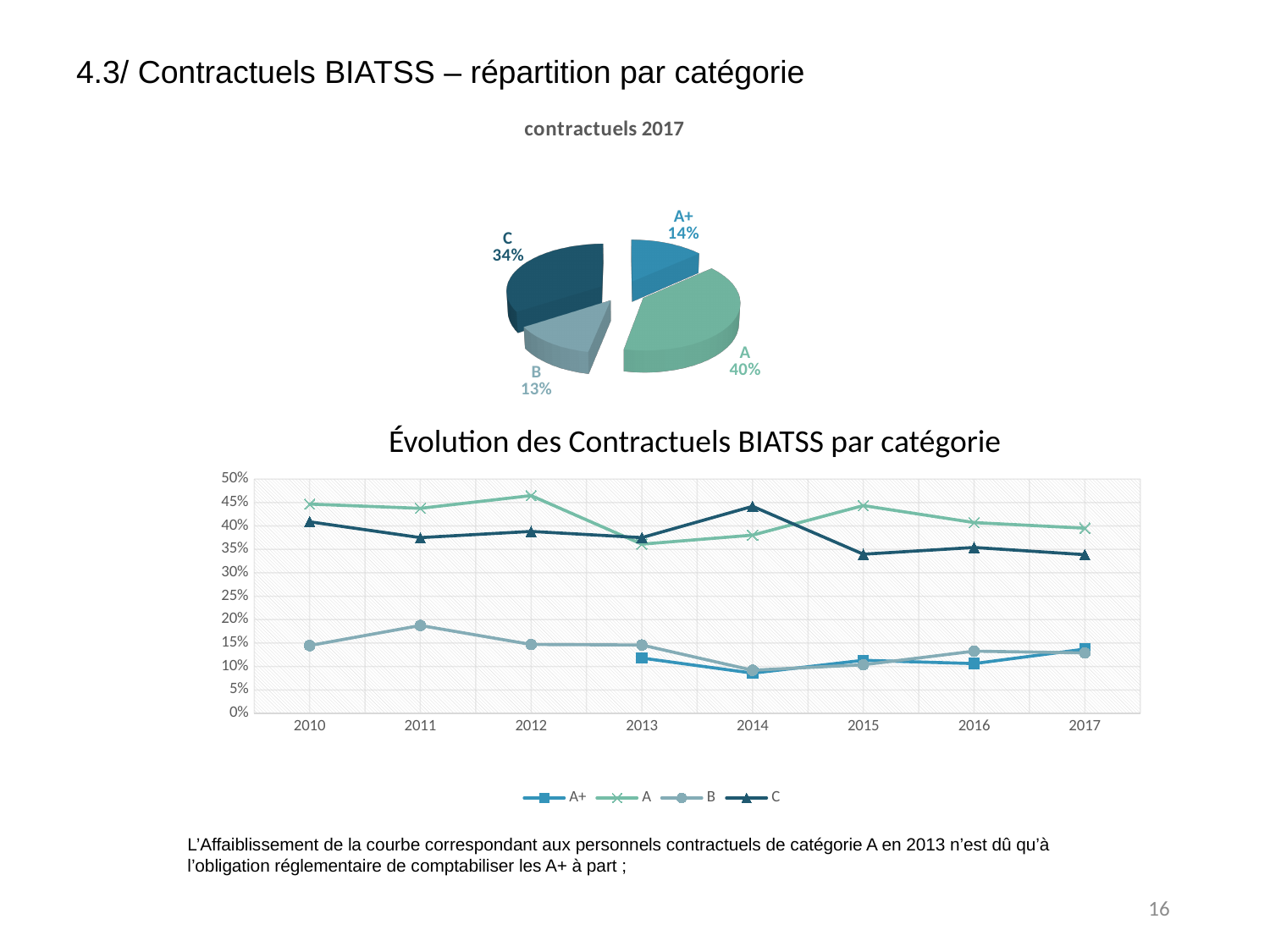
In the chart 'Évolution des Contractuels BIATSS par catégorie', how many years are shown on the x axis? 8 In the pie chart 'contractuels 2017', how many categories are shown? 4 In the chart 'Évolution des Contractuels BIATSS par catégorie', is the value for A+ in 2014 greater or less than 10%? less In the pie chart 'contractuels 2017', which category has the smallest share? B In the chart 'Évolution des Contractuels BIATSS par catégorie', which series has the highest value in 2014? C In the chart 'Évolution des Contractuels BIATSS par catégorie', is the value for B in 2011 greater or less than 15%? greater In the pie chart 'contractuels 2017', which category has the largest share? A In the pie chart 'contractuels 2017', what share is category A? 40% In the pie chart 'contractuels 2017', how many percentage points larger is C's share than A+'s share? 20% In the chart 'Évolution des Contractuels BIATSS par catégorie', how many series does the legend list? 4 What kind of chart is 'Évolution des Contractuels BIATSS par catégorie'? line chart In the pie chart 'contractuels 2017', what share is category C? 34%